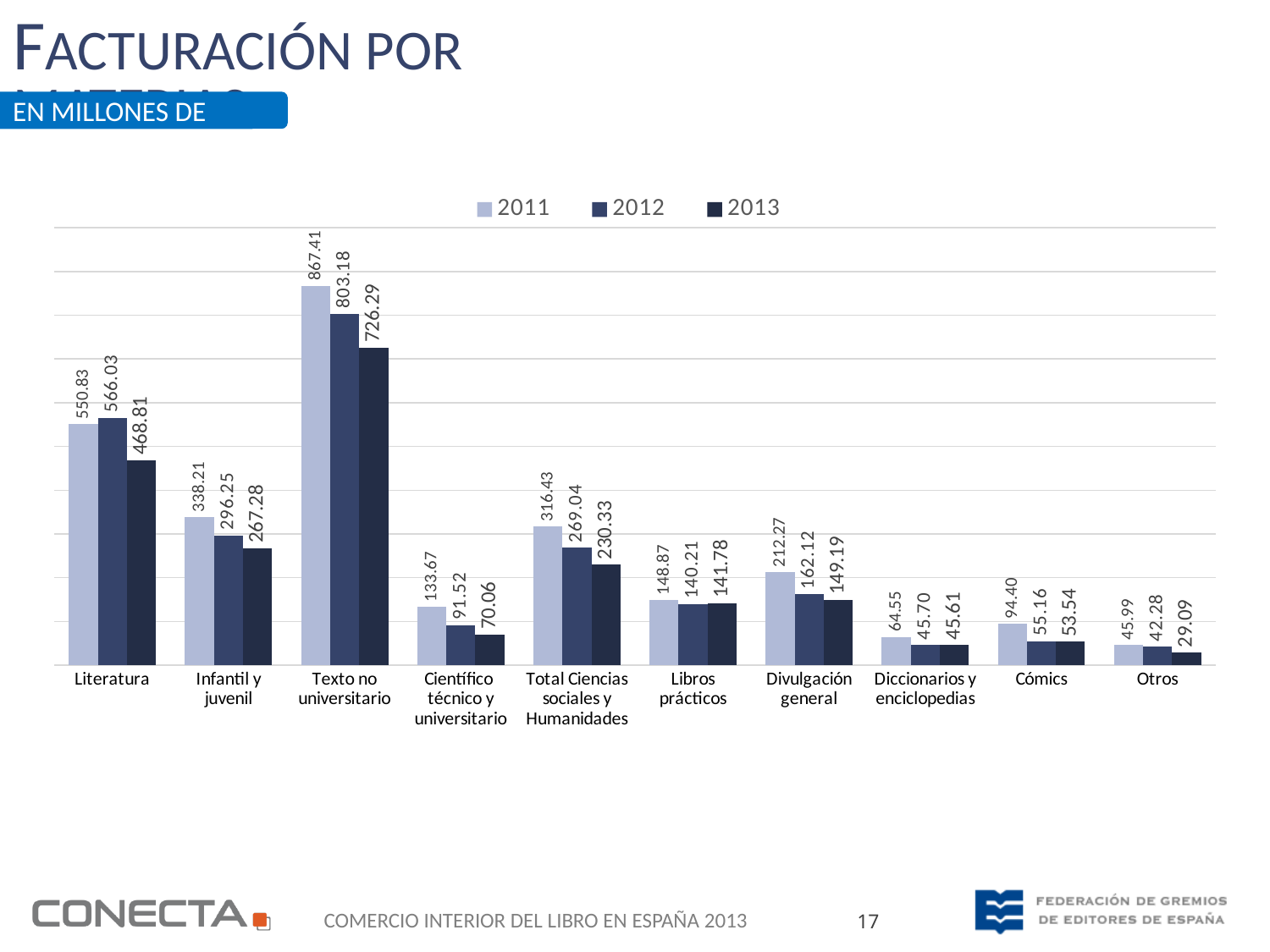
For Literatura, which year has the larger value, 2011 or 2012? 2012 What is the difference between the 2011 and 2013 values for Texto no universitario? 141.12 What kind of chart is shown on the slide? bar chart Do the values for Infantil y juvenil rise or fall from 2011 to 2013? fall Which category has the highest value in 2013? Texto no universitario What is the value for Cómics in 2012? 55.16 What is the difference between the 2012 and 2013 values for Literatura? 97.22 How many series does the legend list? 3 What is the value for Literatura in 2013? 468.81 What is the value for Texto no universitario in 2011? 867.41 How many categories are shown on the x axis? 10 Which category has the lowest value in 2013? Otros